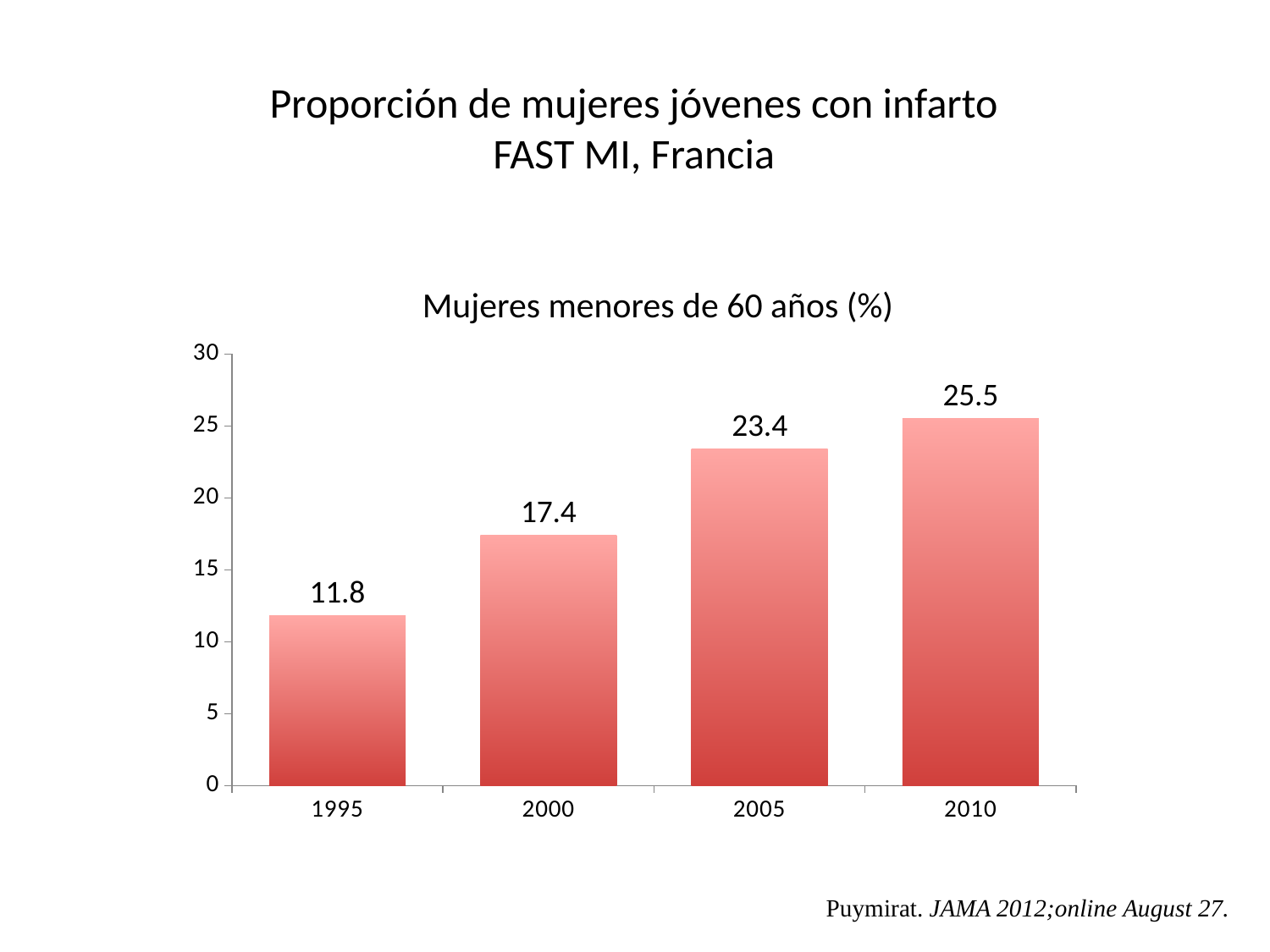
Which year has the lowest value? 1995 What is the value for 2005? 23.4 How many years are shown on the x axis? 4 What kind of chart is shown? bar chart Which year has the highest value? 2010 What is the value for 1995? 11.8 Is the value for 2000 greater or less than 20? less Which is larger, the value for 2000 or the value for 2005? 2005 What is the value for 2010? 25.5 What is the difference between the values for 2010 and 1995? 13.7 Do the values rise or fall from 1995 to 2010? rise What is the difference between the values for 2005 and 2000? 6